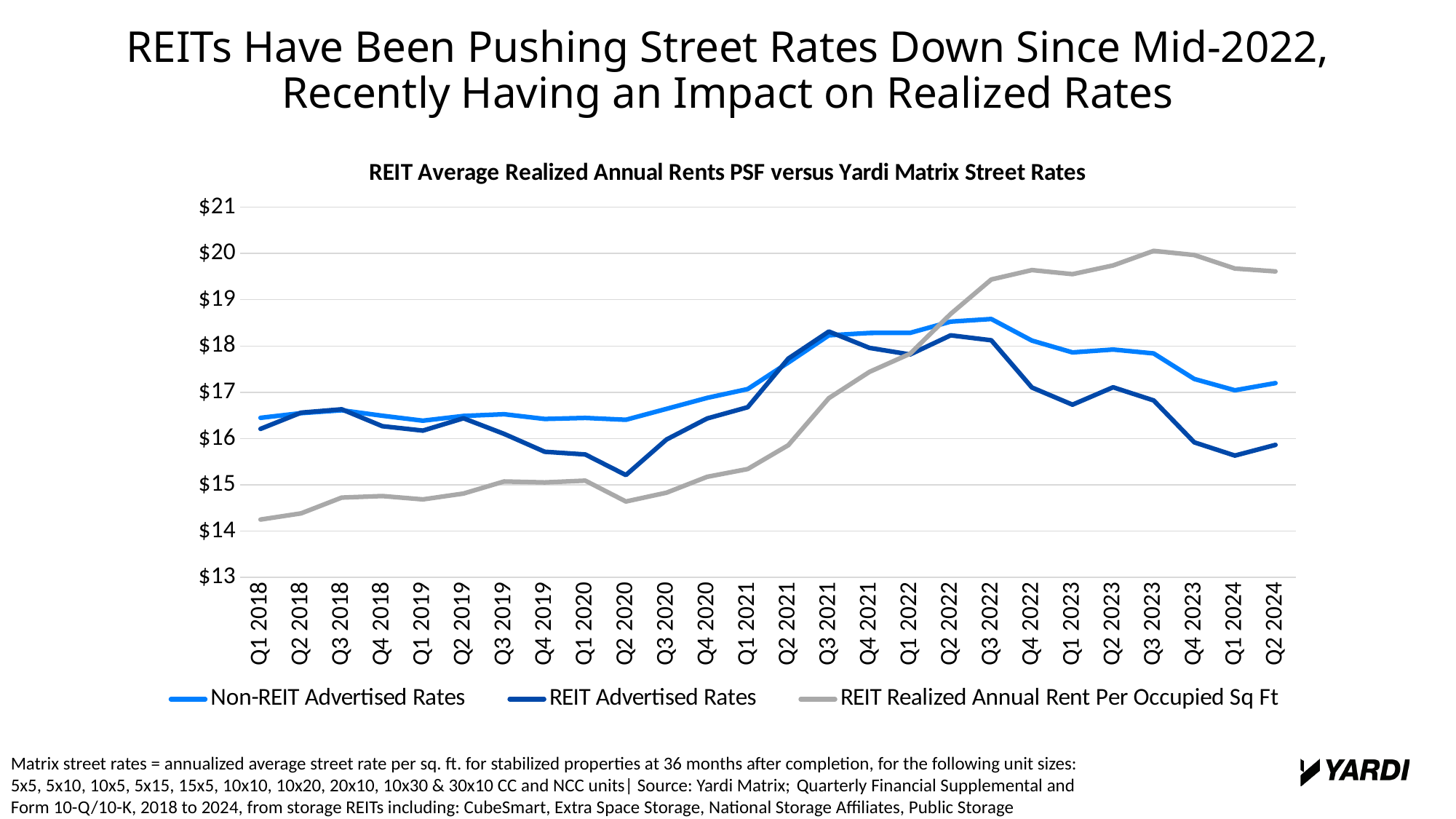
Which series has the highest value in Q2 2024? REIT Realized Annual Rent Per Occupied Sq Ft Is the value for Non-REIT Advertised Rates in Q3 2022 greater or less than $18? greater Is the value for REIT Realized Annual Rent Per Occupied Sq Ft in Q3 2023 greater or less than $19? greater Do REIT Advertised Rates rise or fall from Q3 2022 to Q2 2024? Fall In Q2 2024, which is larger: Non-REIT Advertised Rates or REIT Advertised Rates? Non-REIT Advertised Rates Which series has the lowest value in Q1 2018? REIT Realized Annual Rent Per Occupied Sq Ft How many series does the legend list? 3 Is the value for REIT Advertised Rates in Q2 2024 greater or less than $16? less What is the title of the chart? REIT Average Realized Annual Rents PSF versus Yardi Matrix Street Rates What kind of chart is shown on the slide? Line chart How many quarters are plotted along the x axis? 26